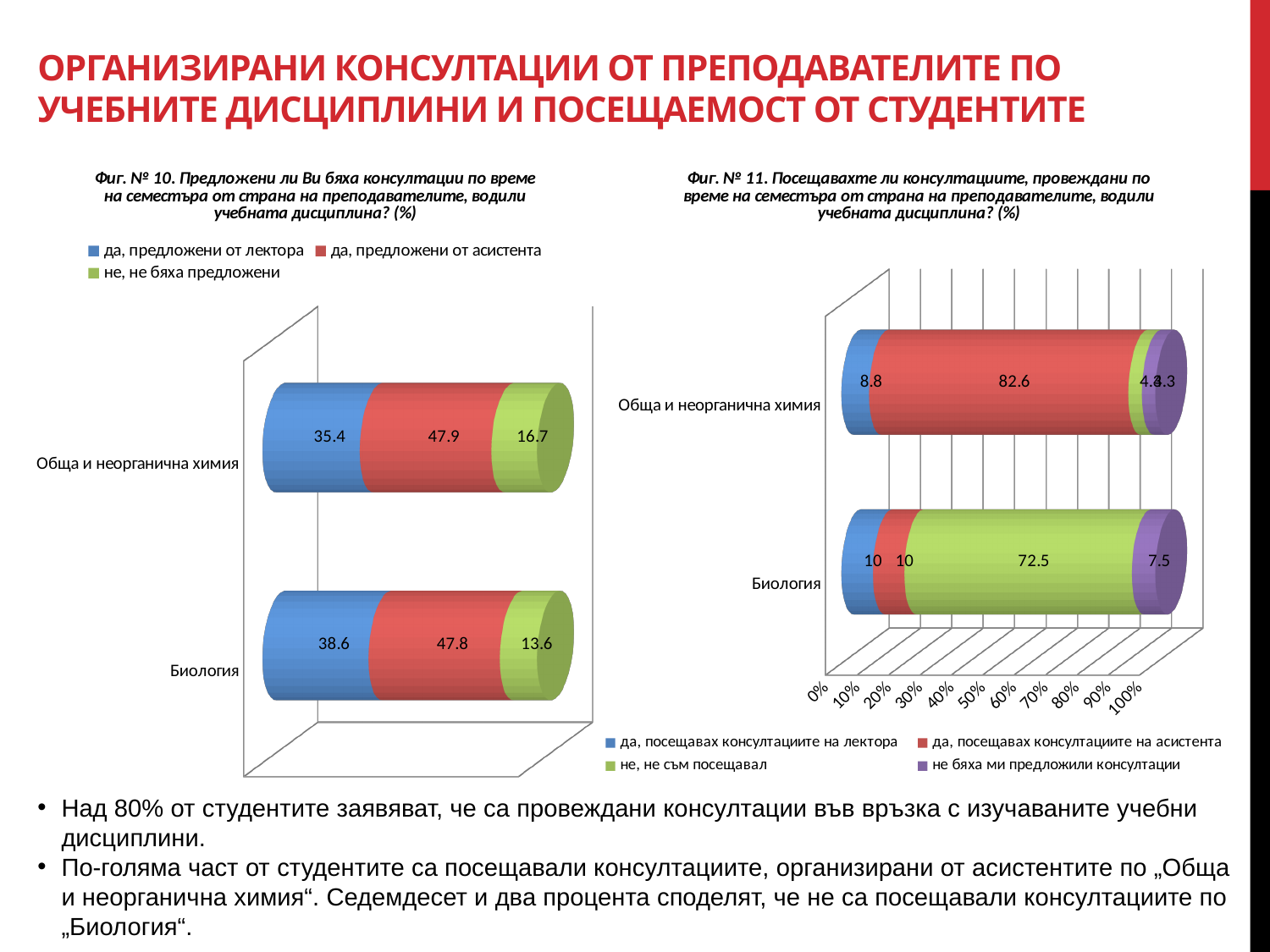
In the chart Фиг. № 10 (left), how many series does the legend list? 3 In the chart Фиг. № 10 (left), what is the value for 'да, предложени от асистента' for Биология? 47.8 In the chart Фиг. № 11 (right), what is the value for 'не бяха ми предложили консултации' for Биология? 7.5 In the chart Фиг. № 11 (right), what is the value for 'да, посещавах консултациите на асистента' for Обща и неорганична химия? 82.6 In the chart Фиг. № 11 (right), what is the value for 'не, не съм посещавал' for Биология? 72.5 In the chart Фиг. № 11 (right), how many series does the legend list? 4 In the chart Фиг. № 10 (left), what is the difference between the 'да, предложени от лектора' values for Биология and Обща и неорганична химия? 3.2 What kind of chart is Фиг. № 11 (right)? Stacked bar chart In the chart Фиг. № 11 (right), which series has the lowest value for Биология? не бяха ми предложили консултации In the chart Фиг. № 10 (left), what is the value for 'да, предложени от лектора' for Обща и неорганична химия? 35.4 In the chart Фиг. № 10 (left), which series has the highest value for Обща и неорганична химия? да, предложени от асистента In the chart Фиг. № 10 (left), what is the value for 'не, не бяха предложени' for Биология? 13.6